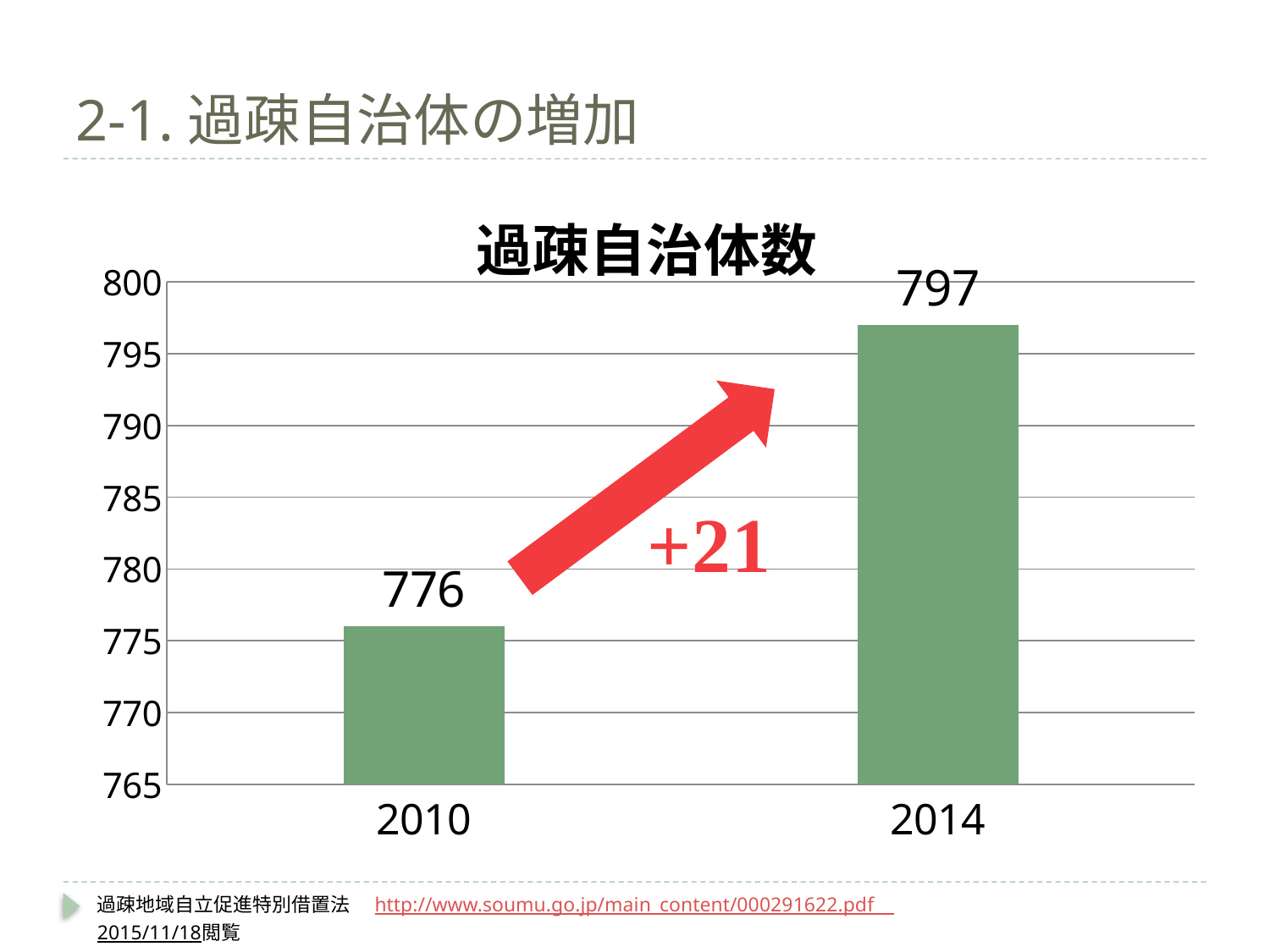
How many categories are shown on the x axis? 2 What is the difference between the values for 2014 and 2010? 21 What is the value for 2010? 776 Which year has the highest value? 2014 Do the values rise or fall from 2010 to 2014? rise What is the value for 2014? 797 What is the title of the chart? 過疎自治体数 Is the value for 2010 greater or less than 780? less Is the value for 2014 greater or less than 795? greater What kind of chart is shown on the slide? bar chart Which year has the lowest value? 2010 Which is larger, the value for 2010 or the value for 2014? 2014